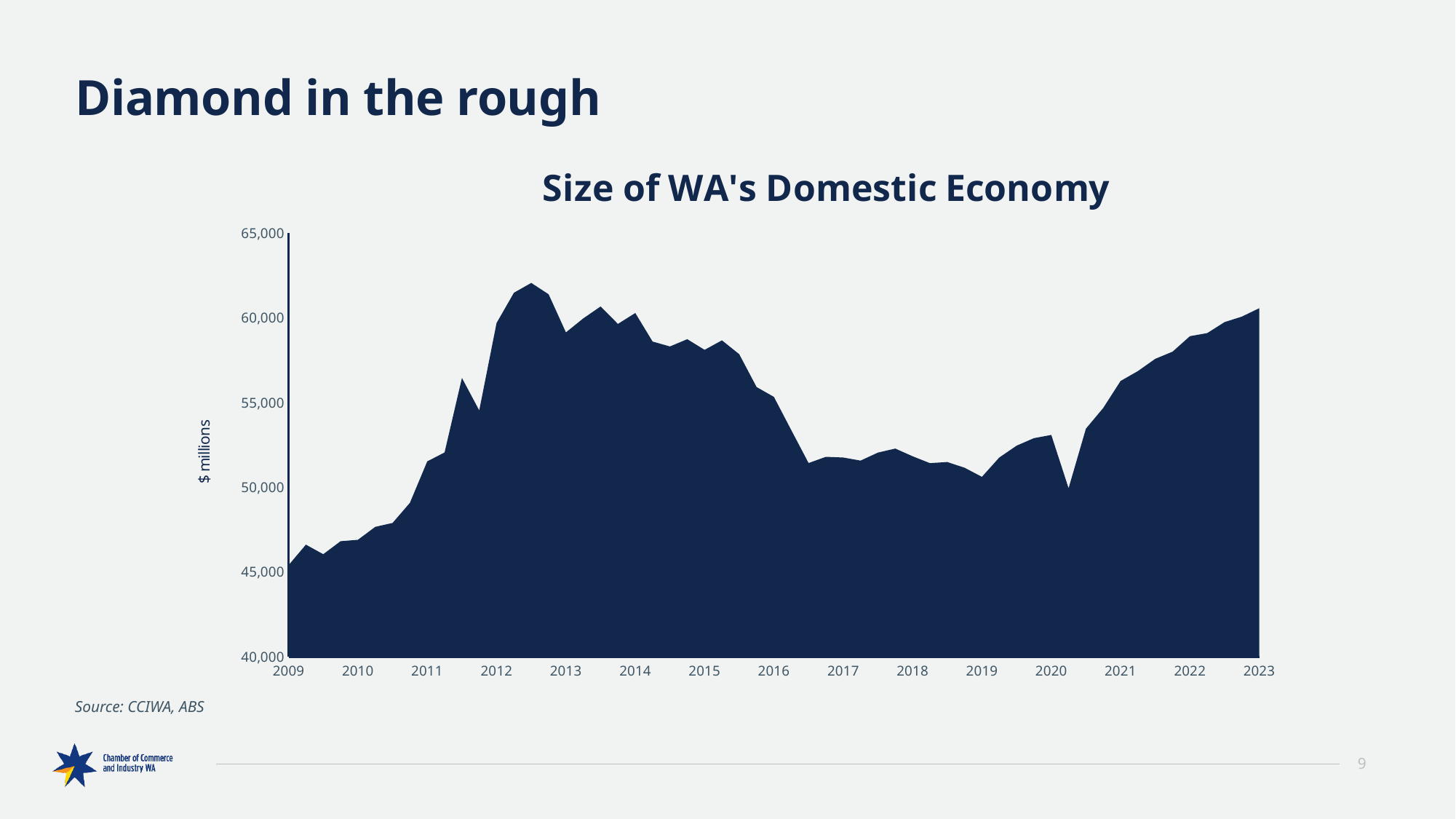
Is the value at 2017 greater or less than 55,000? less What unit is shown on the vertical axis label of the chart? $ millions Is the value at 2017 greater or less than 50,000? greater Is the value at 2021 greater or less than 60,000? less Which is larger, the value at 2009 or the value at 2023? 2023 Does the value rise or fall between 2020 and 2023? rise How many year labels are shown along the x axis of the chart? 15 Does the value rise or fall between 2009 and 2012? rise What type of chart is shown on the slide? Area chart What is the title of the chart? Size of WA's Domestic Economy